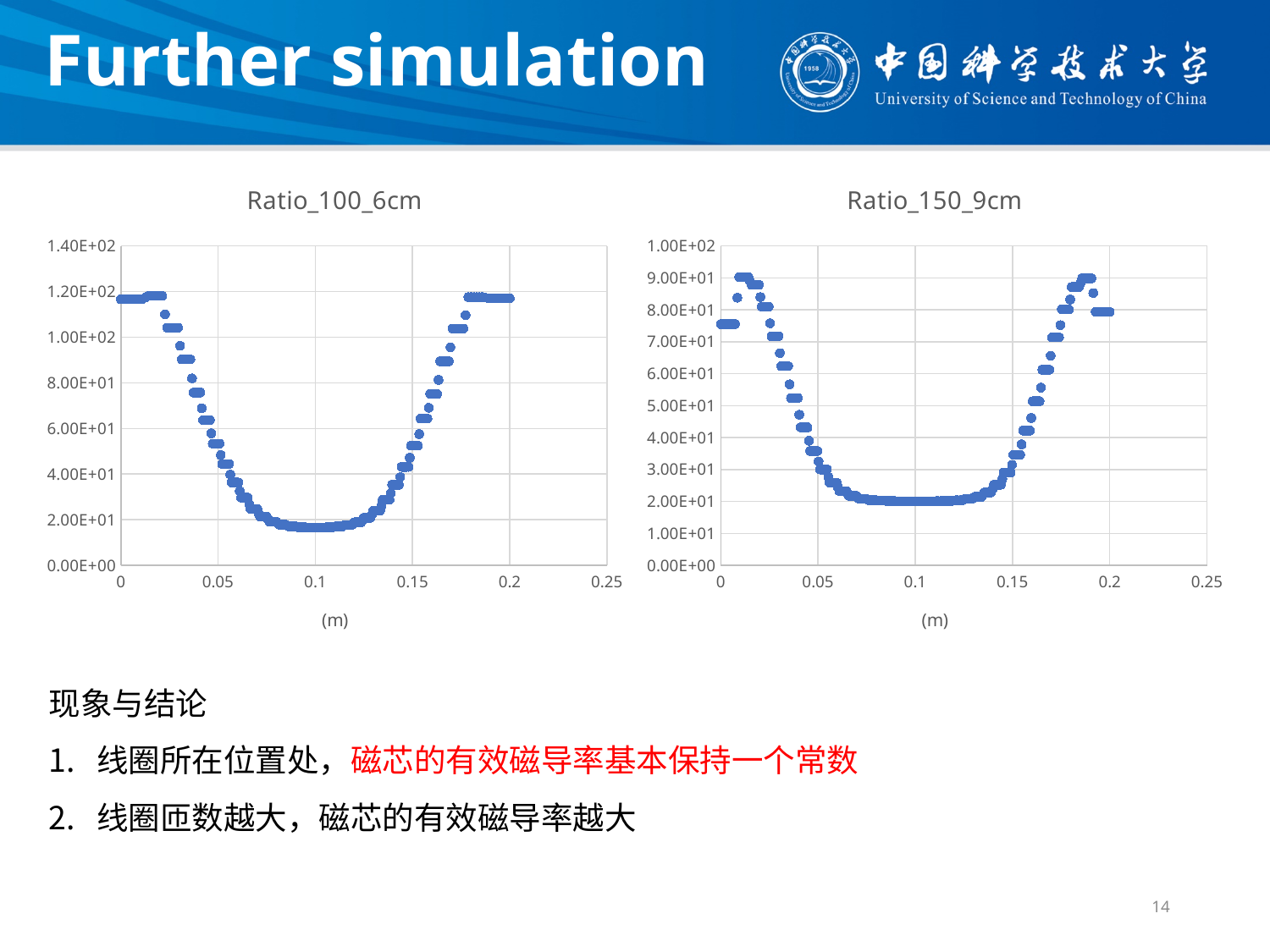
What kind of chart is the left chart titled Ratio_100_6cm? scatter chart In the Ratio_100_6cm chart, is the value at x = 0.1 greater or less than 2.00E+01? less In the Ratio_150_9cm chart, which is larger: the value at x = 0 or the value at x = 0.02? the value at x = 0.02 In the Ratio_150_9cm chart, is the value at x = 0.1 greater or less than 3.00E+01? less What is the title of the right chart? Ratio_150_9cm In the Ratio_100_6cm chart, which is larger: the value at x = 0 or the value at x = 0.1? the value at x = 0 In the Ratio_150_9cm chart, do the values rise or fall as x goes from 0.15 to 0.19? rise In the Ratio_100_6cm chart, is the value at x = 0 greater or less than 1.00E+02? greater What is the x-axis label on the left chart, Ratio_100_6cm? (m) In the Ratio_100_6cm chart, do the values rise or fall as x goes from 0.05 to 0.1? fall